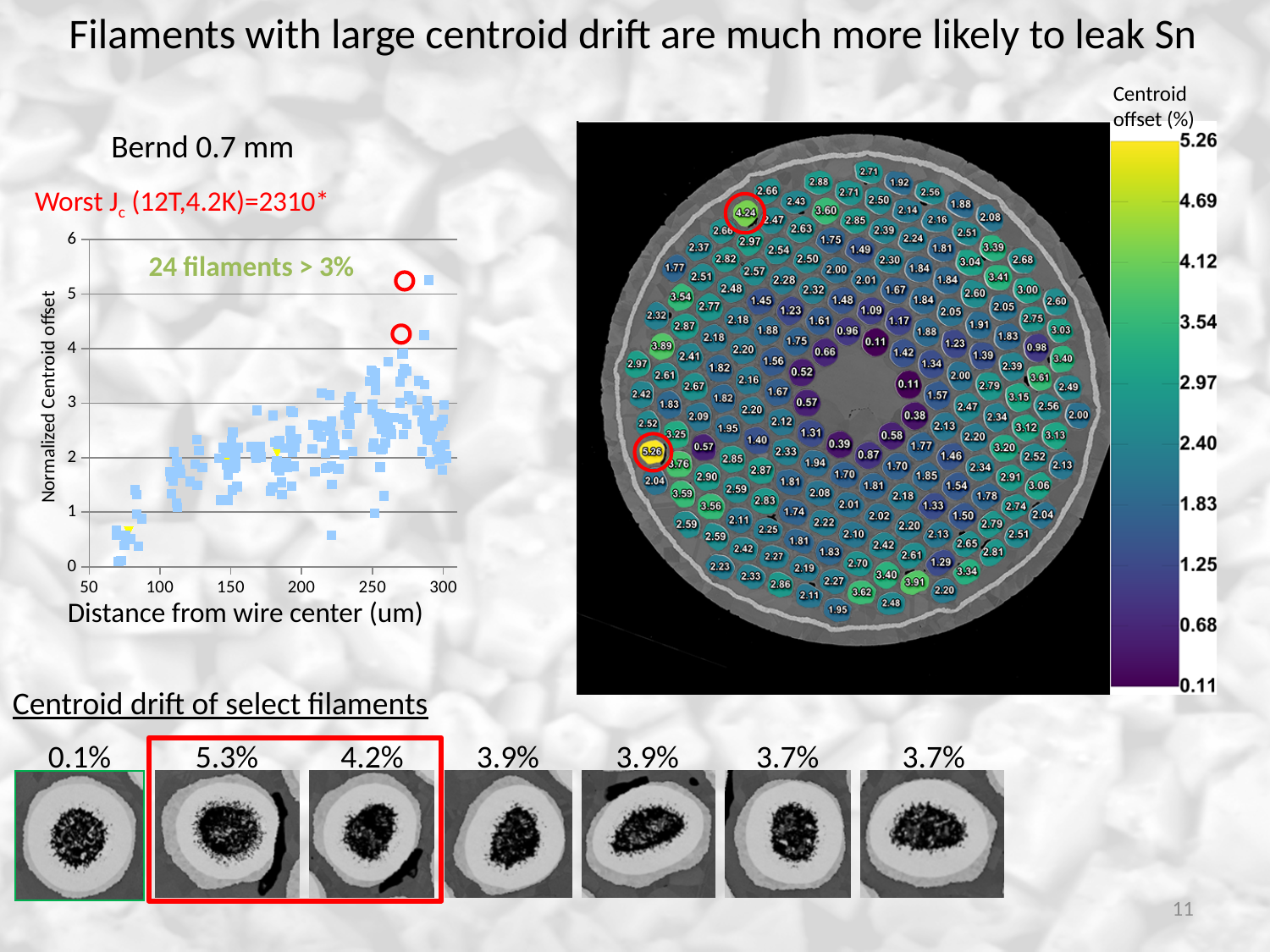
In the scatter chart on the left, is the second-highest circled point greater or less than 4? greater According to the annotation on the scatter chart, how many filaments have a centroid offset greater than 3%? 24 In the scatter chart on the left, is the highest plotted normalized centroid offset greater or less than 5? greater In the scatter chart on the left, are the highest normalized centroid offsets found near the wire center or near the outer edge of the wire? near the outer edge In the scatter chart on the left, do the normalized centroid offset values generally rise or fall as distance from the wire center increases? rise How many data points are circled in red on the scatter chart on the left? 2 On the colour scale for the centroid offset map on the right, what is the minimum value shown? 0.11 In the scatter chart on the left, are the points plotted nearest 75 um from the wire center greater or less than 1? less What kind of chart is the 'Bernd 0.7 mm' plot on the left of the slide? scatter chart In the scatter chart on the left, what is the label of the x axis? Distance from wire center (um) On the colour scale for the centroid offset map on the right, what is the maximum value shown? 5.26